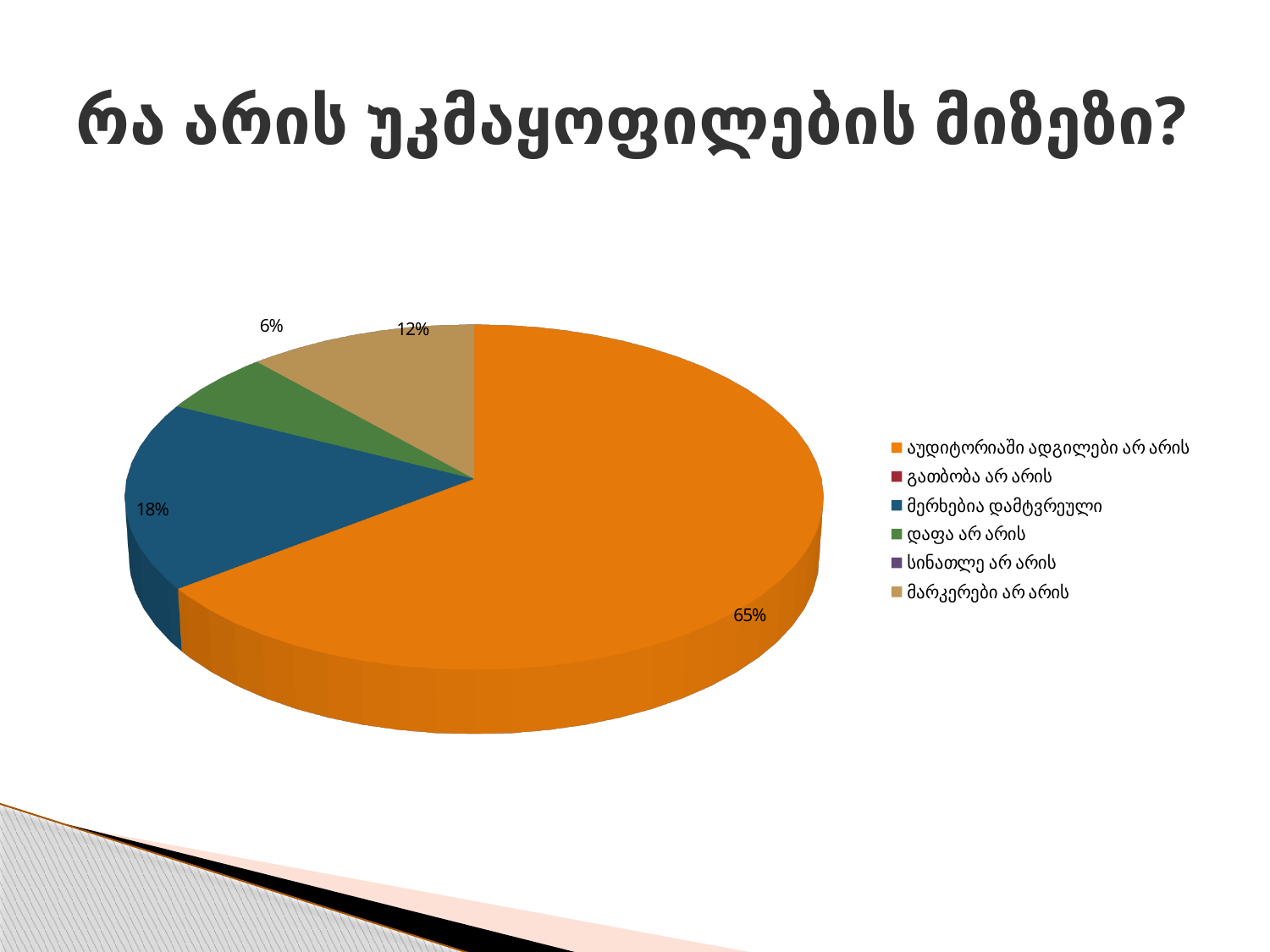
What type of chart is shown on the slide? pie chart What percentage is shown for მერხებია დამტვრეული? 18% Among the slices labeled with a percentage, which category has the smallest share? დაფა არ არის What is the difference in percentage points between აუდიტორიაში ადგილები არ არის and მერხებია დამტვრეული? 47 What is the title of the slide? რა არის უკმაყოფილების მიზეზი? What percentage of the pie is labeled for აუდიტორიაში ადგილები არ არის? 65% What percentage is shown for მარკერები არ არის? 12% Which category has the largest slice of the pie? აუდიტორიაში ადგილები არ არის How many slices of the pie are labeled with a percentage? 4 How many entries does the legend list? 6 Which is larger: the slice for მარკერები არ არის or the slice for დაფა არ არის? მარკერები არ არის What percentage is shown for დაფა არ არის? 6%